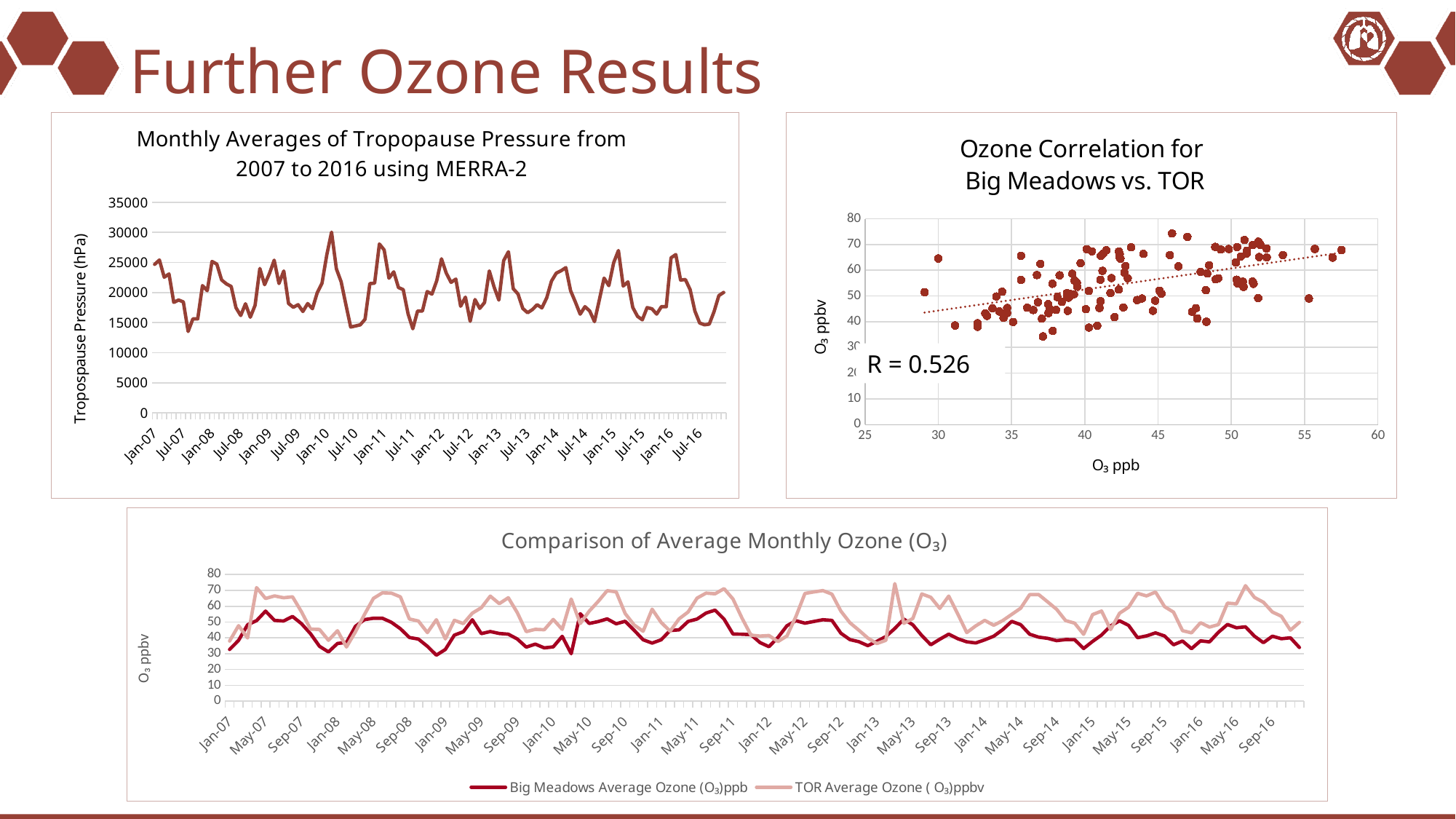
In the 'Monthly Averages of Tropopause Pressure' chart, is the highest value plotted greater or less than 25000? greater What is the y-axis title of the 'Monthly Averages of Tropopause Pressure' chart? Tropopause Pressure (hPa) In the 'Comparison of Average Monthly Ozone (O₃)' chart, how many series does the legend list? 2 In the 'Ozone Correlation for Big Meadows vs. TOR' chart, what R value is printed? R = 0.526 What kind of chart is the 'Monthly Averages of Tropopause Pressure from 2007 to 2016 using MERRA-2' chart? line chart In the 'Comparison of Average Monthly Ozone (O₃)' chart, which series is generally higher, Big Meadows or TOR? TOR In the 'Ozone Correlation for Big Meadows vs. TOR' chart, does the dotted trend line rise or fall as O₃ ppb increases? rise In the 'Comparison of Average Monthly Ozone (O₃)' chart, is the highest TOR value greater or less than 70? greater In the 'Comparison of Average Monthly Ozone (O₃)' chart, what are the two legend entries? Big Meadows Average Ozone (O₃)ppb and TOR Average Ozone ( O₃)ppbv In the 'Ozone Correlation for Big Meadows vs. TOR' chart, what is the maximum value shown on the x axis? 60 What kind of chart is the 'Ozone Correlation for Big Meadows vs. TOR' chart? scatter chart In the 'Monthly Averages of Tropopause Pressure' chart, is the lowest value plotted greater or less than 15000? less